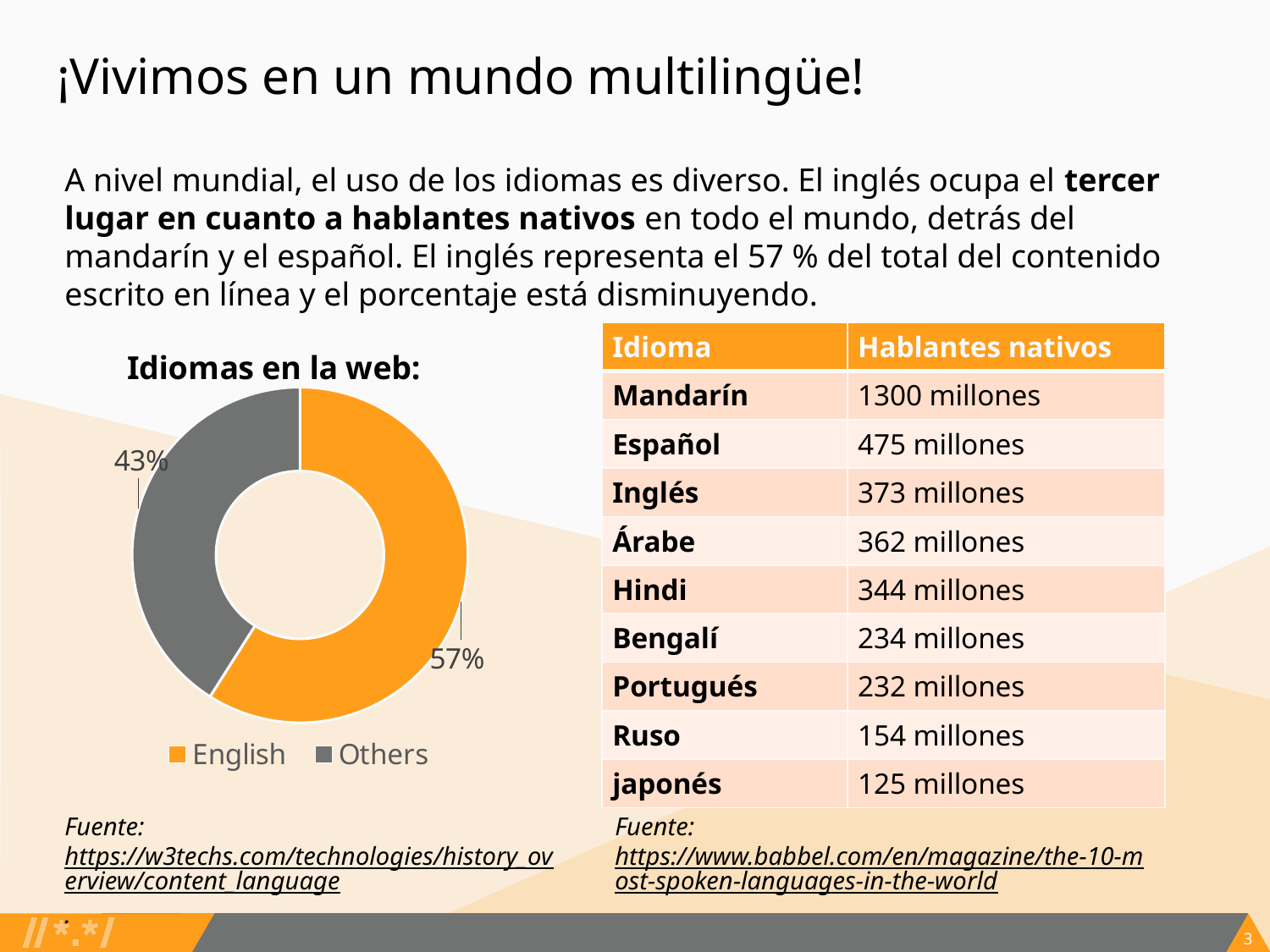
Is the share for Others in the "Idiomas en la web:" chart greater or less than 50%? less What is the title of the doughnut chart on the slide? Idiomas en la web: What is the difference in percentage points between the English and Others slices in the "Idiomas en la web:" chart? 14 Which category has the smallest slice in the "Idiomas en la web:" chart? Others Which slice is larger in the "Idiomas en la web:" chart, English or Others? English What kind of chart is shown under the title "Idiomas en la web:"? doughnut chart In the "Idiomas en la web:" chart, what share is shown for English? 57% How many categories does the "Idiomas en la web:" chart show? 2 How many entries does the legend of the "Idiomas en la web:" chart list? 2 What colour is the English slice in the "Idiomas en la web:" chart? orange In the "Idiomas en la web:" chart, what share is shown for Others? 43% Which category has the largest slice in the "Idiomas en la web:" chart? English